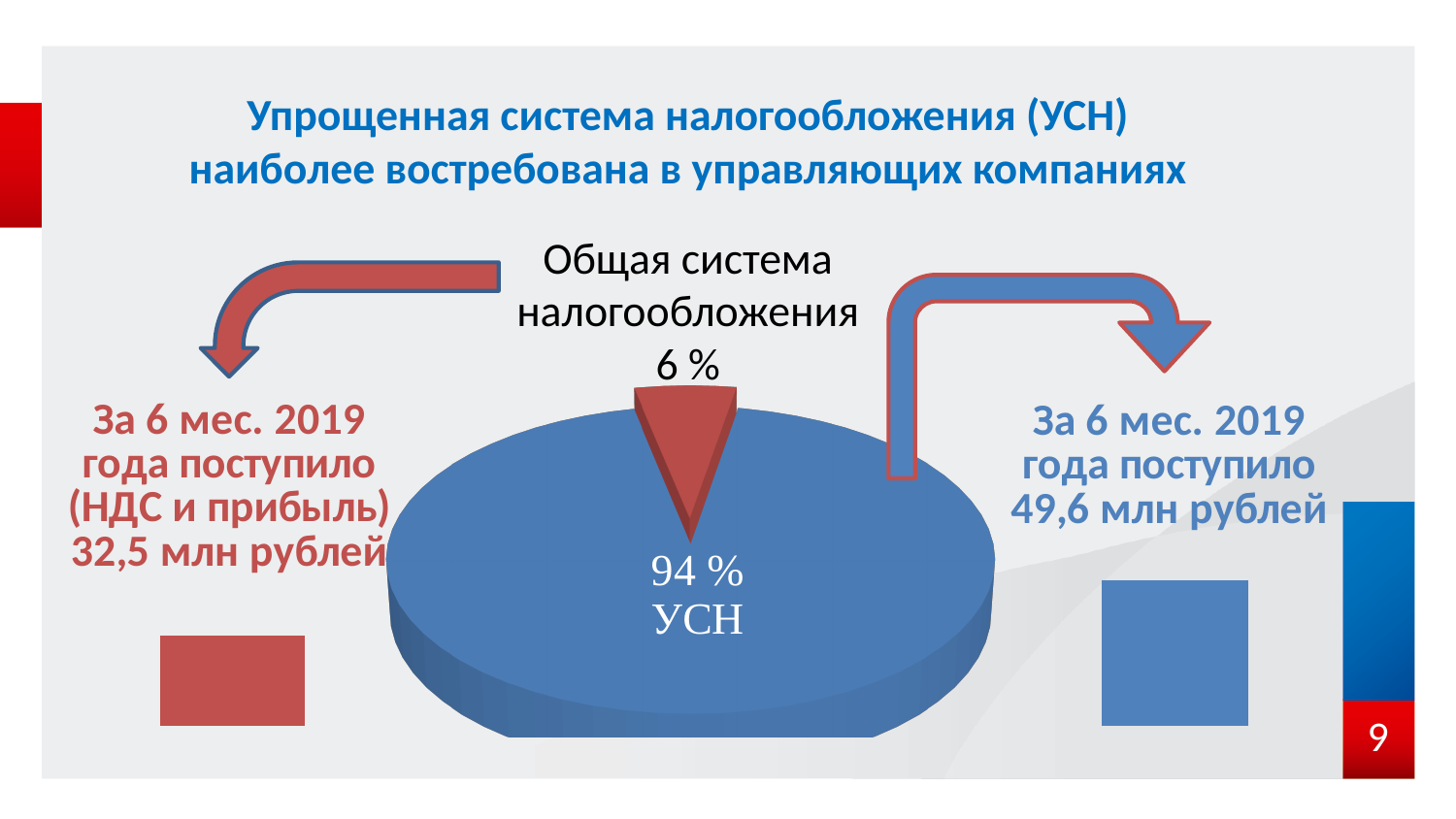
Which is larger in the pie chart: УСН or Общая система налогообложения? УСН According to the annotation next to the pie chart, how much was received under УСН for 6 months of 2019? 49,6 млн рублей What share of the pie chart does УСН account for? 94 % Which slice of the pie chart is the largest? УСН How many slices does the pie chart have? 2 According to the annotation next to the pie chart, how much was received under the general taxation system (НДС и прибыль) for 6 months of 2019? 32,5 млн рублей By how many percentage points does the УСН slice exceed the Общая система налогообложения slice? 88 % What do the two slices of the pie chart add up to? 100 % What colour is the УСН slice of the pie chart? blue What share of the pie chart does Общая система налогообложения account for? 6 % What kind of chart is shown on the slide? pie chart Which slice of the pie chart is the smallest? Общая система налогообложения